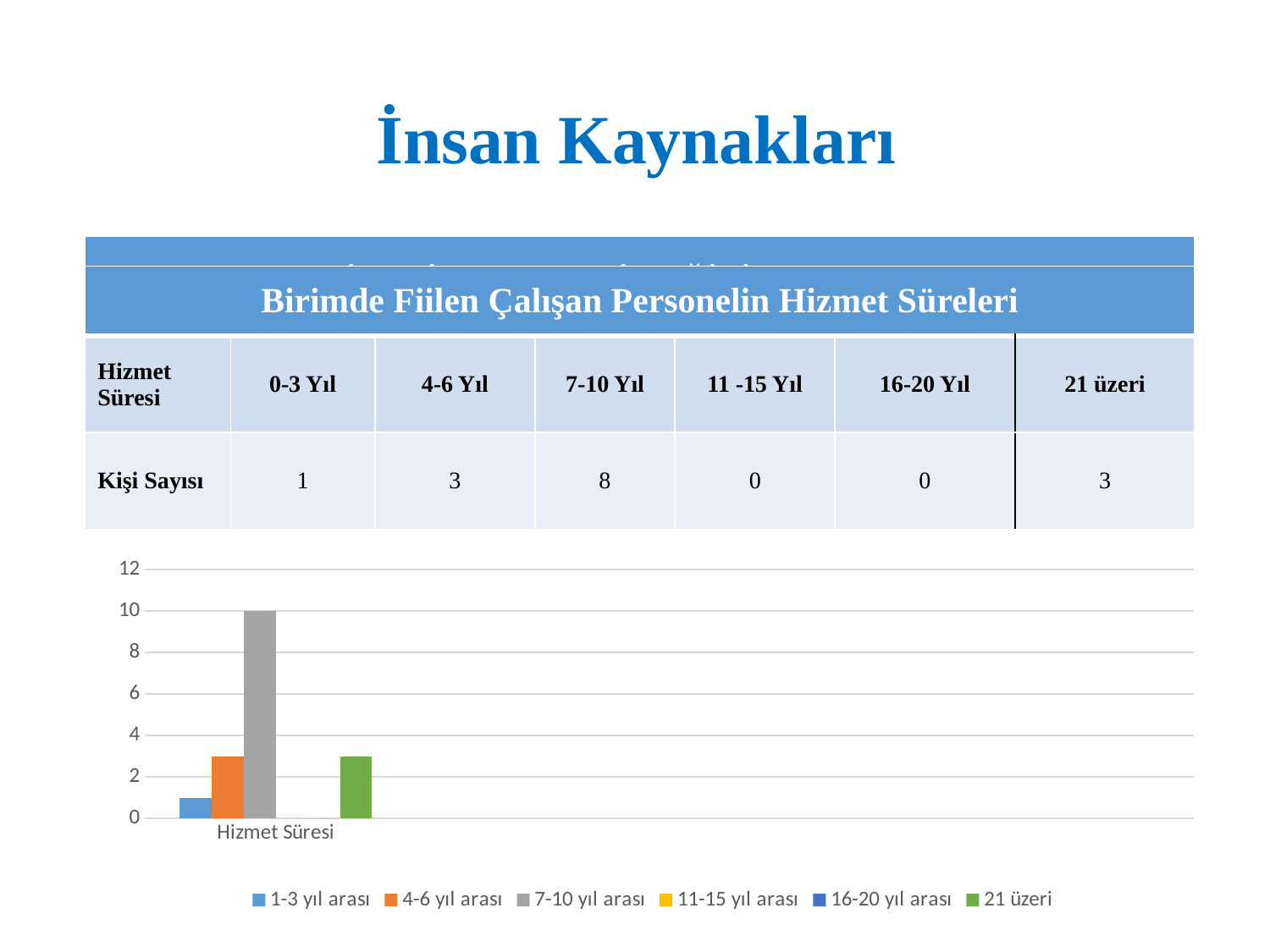
Is the value for 4-6 yıl arası in the chart greater or less than 4? less How many series does the chart legend list? 6 What is the category label on the x axis of the chart? Hizmet Süresi How many categories are shown on the x axis of the chart? 1 Is the value for 21 üzeri in the chart greater or less than 2? greater What kind of chart is shown on the slide? bar chart In the chart, which bar is taller: 4-6 yıl arası or 1-3 yıl arası? 4-6 yıl arası Is the value for 7-10 yıl arası in the chart greater or less than 6? greater In the chart, which bar is taller: 21 üzeri or 7-10 yıl arası? 7-10 yıl arası What colour is the bar for 7-10 yıl arası in the chart? grey Which series has the tallest bar in the chart? 7-10 yıl arası